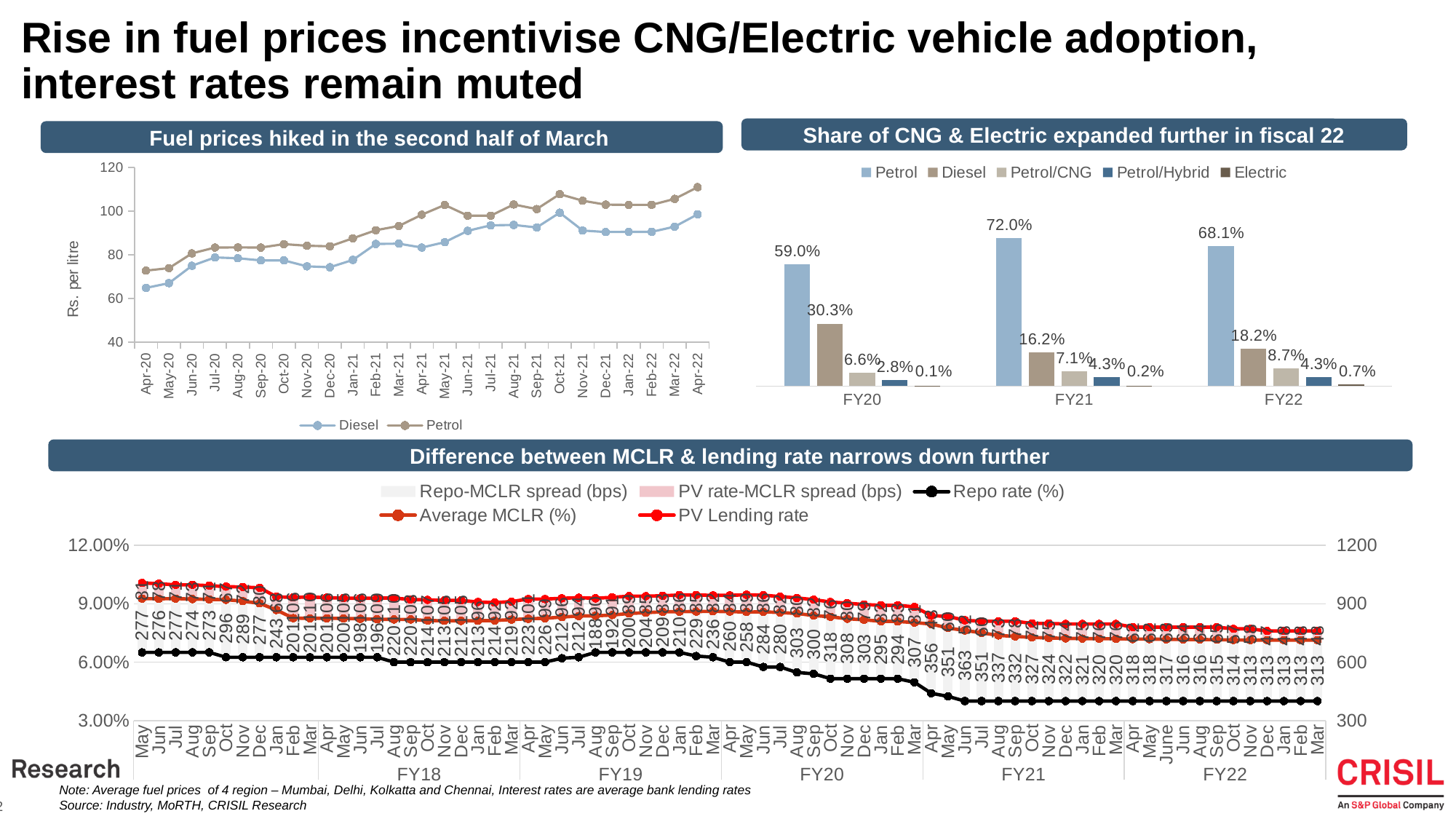
In the chart 'Share of CNG & Electric expanded further in fiscal 22', by how many percentage points did the Diesel share fall from FY20 to FY22? 12.1 percentage points In the chart 'Share of CNG & Electric expanded further in fiscal 22', what is the share of Petrol in FY21? 72.0% In the chart 'Share of CNG & Electric expanded further in fiscal 22', in which fiscal year is the Petrol share highest? FY21 In the chart 'Share of CNG & Electric expanded further in fiscal 22', what is the share of Electric in FY22? 0.7% How many series does the legend of the chart 'Share of CNG & Electric expanded further in fiscal 22' list? 5 How many series does the legend of the chart 'Difference between MCLR & lending rate narrows down further' list? 5 In the chart 'Fuel prices hiked in the second half of March', is the Diesel price in Apr-20 greater or less than 80? less In the chart 'Share of CNG & Electric expanded further in fiscal 22', what is the share of Petrol/CNG in FY22? 8.7% What kind of chart is 'Fuel prices hiked in the second half of March'? Line chart In the chart 'Share of CNG & Electric expanded further in fiscal 22', what is the share of Diesel in FY20? 30.3% In the chart 'Fuel prices hiked in the second half of March', is the Petrol price in Apr-22 greater or less than 100? greater In the chart 'Fuel prices hiked in the second half of March', which is higher in Apr-22, Petrol or Diesel? Petrol